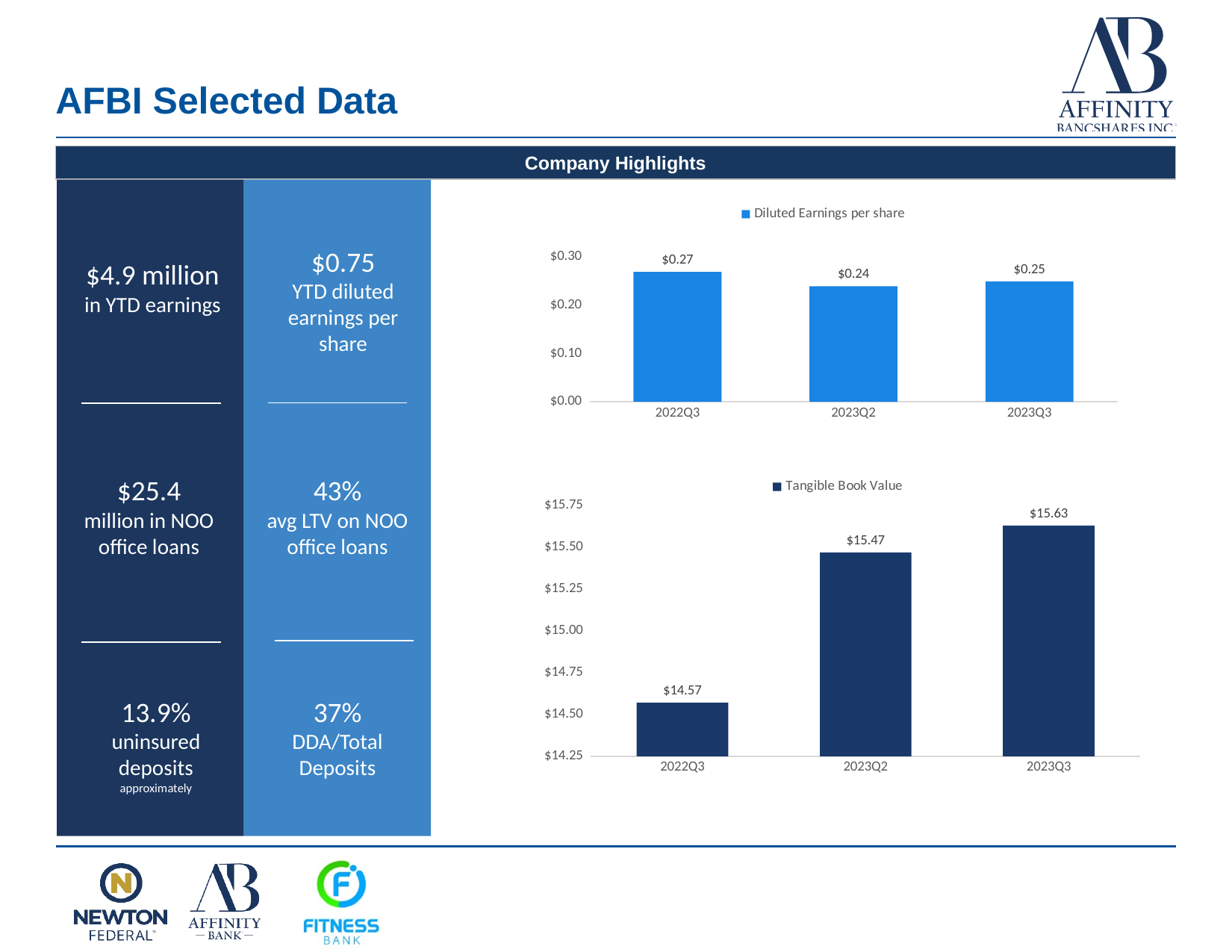
In the Diluted Earnings per share chart, what is the difference between 2022Q3 and 2023Q3? $0.02 In the Diluted Earnings per share chart, what is the value for 2022Q3? $0.27 In the Tangible Book Value chart, do the values rise or fall from 2022Q3 to 2023Q3? rise In the Diluted Earnings per share chart, how many quarters are shown? 3 In the Tangible Book Value chart, which quarter has the highest value? 2023Q3 In the Tangible Book Value chart, what is the value for 2023Q3? $15.63 In the Tangible Book Value chart, which is larger, the value for 2023Q2 or 2022Q3? 2023Q2 What kind of chart is the Tangible Book Value chart? bar chart In the Tangible Book Value chart, what is the difference between 2023Q2 and 2022Q3? $0.90 In the Diluted Earnings per share chart, which quarter has the lowest value? 2023Q2 In the Diluted Earnings per share chart, is the value for 2023Q2 greater or less than $0.20? greater How many series does the legend of the Diluted Earnings per share chart list? 1